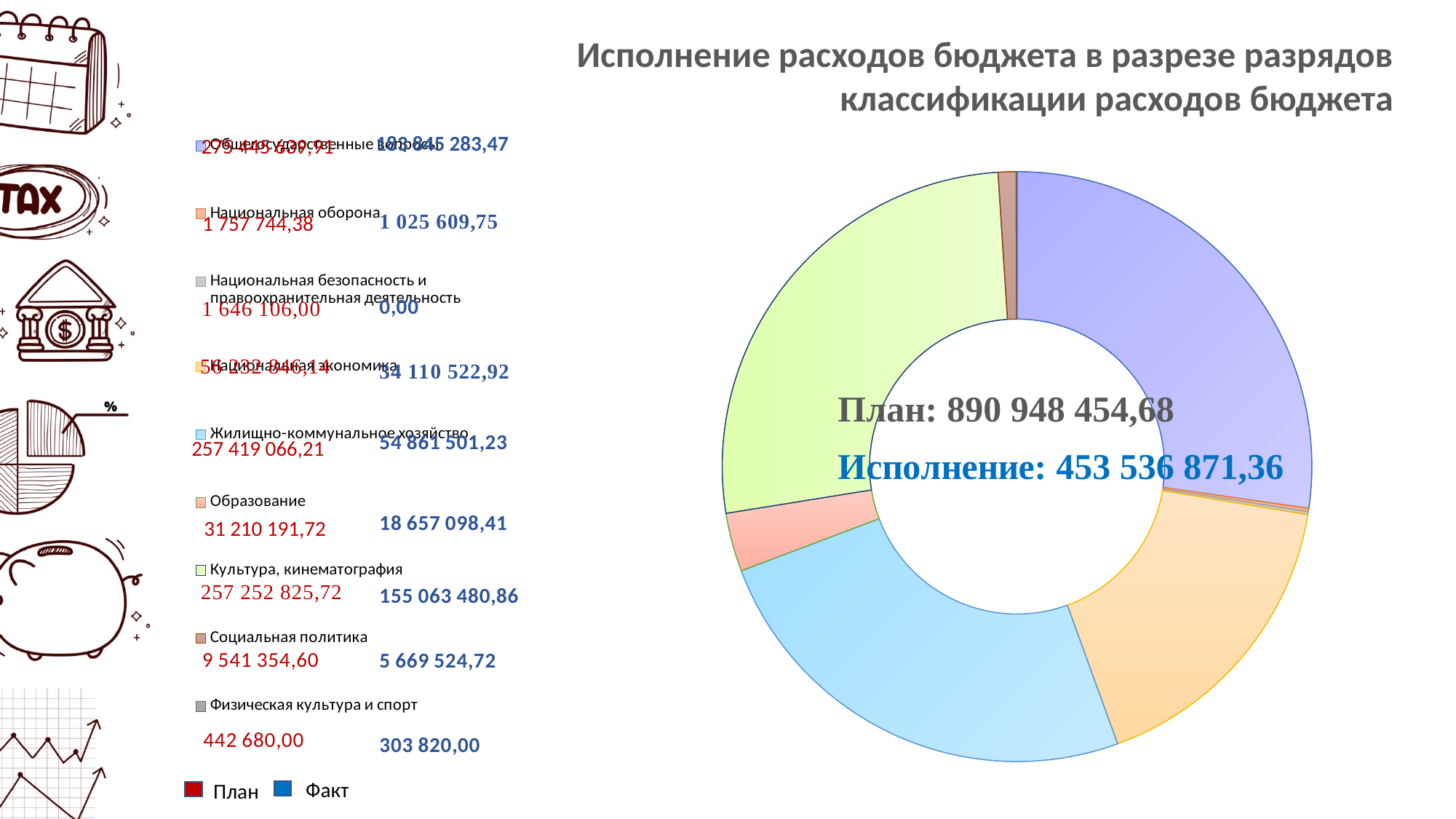
Which category has the lowest fact (Факт) value? Национальная безопасность и правоохранительная деятельность What is the fact (Факт) value for Культура, кинематография? 155 063 480,86 What kind of chart is shown on the slide? Doughnut (pie) chart What total execution (Исполнение) value is shown in the centre of the doughnut chart? 453 536 871,36 What is the difference between the plan and fact values for Образование? 12 553 093,31 What is the difference between the plan and fact values for Физическая культура и спорт? 138 860,00 What is the fact (Факт) value for Национальная безопасность и правоохранительная деятельность? 0,00 Which has the larger fact (Факт) value: Культура, кинематография or Жилищно-коммунальное хозяйство? Культура, кинематография How many categories are listed in the chart legend? 9 What is the plan (План) value for Национальная оборона? 1 757 744,38 What total plan (План) value is shown in the centre of the doughnut chart? 890 948 454,68 What is the plan (План) value for Жилищно-коммунальное хозяйство? 257 419 066,21